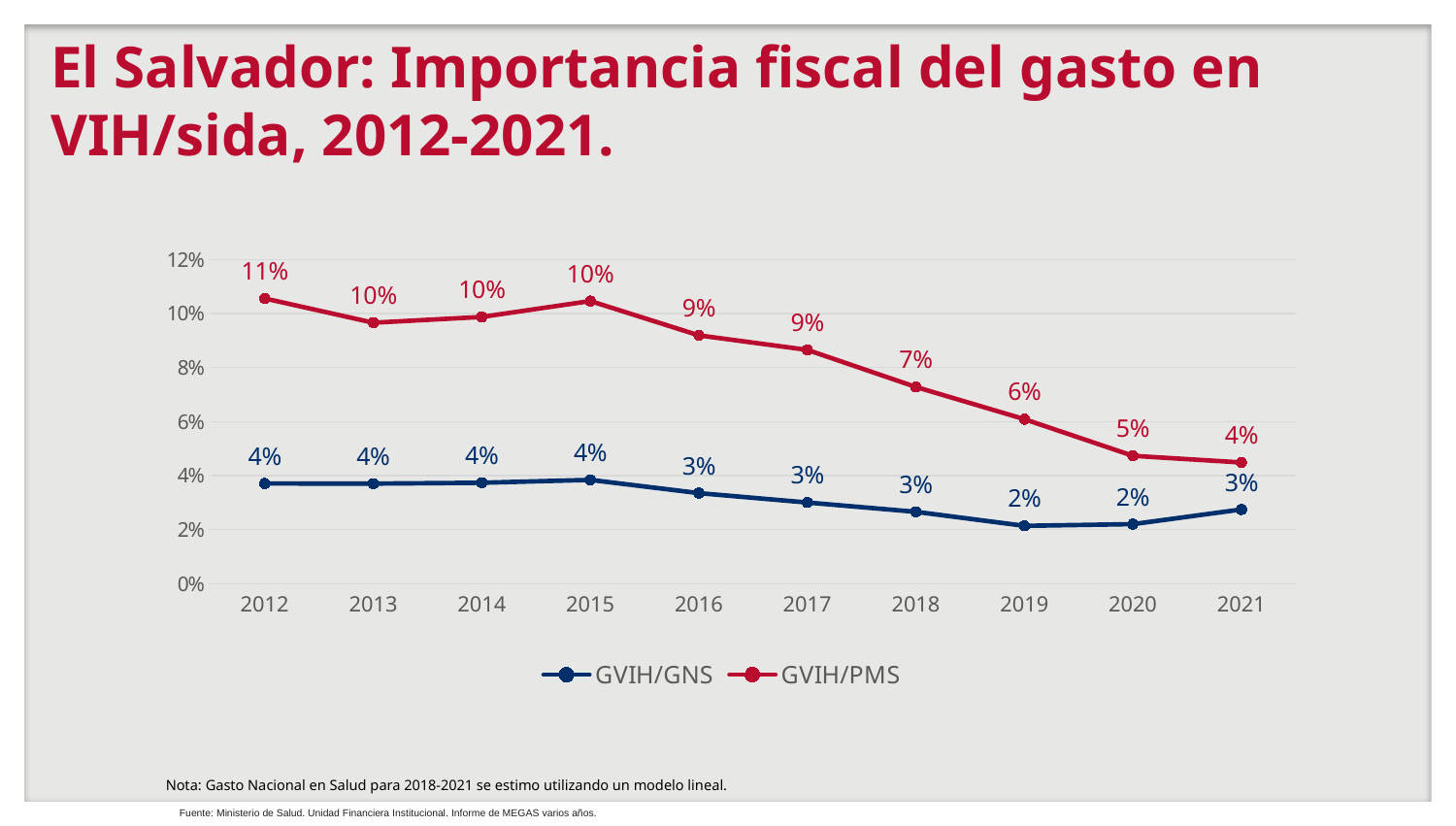
What is the value of GVIH/PMS in 2012? 11% Which series has the larger value in 2015, GVIH/GNS or GVIH/PMS? GVIH/PMS What kind of chart is shown on the slide? line chart In which year is GVIH/PMS at its highest? 2012 What is the value of GVIH/GNS in 2019? 2% Is the value for GVIH/PMS in 2017 greater or less than 8%? greater Does GVIH/PMS generally rise or fall from 2012 to 2021? fall How many years are shown on the x axis? 10 What is the lowest labelled value of GVIH/GNS? 2% How many series does the legend list? 2 What is the value of GVIH/PMS in 2021? 4% What is the difference between GVIH/PMS and GVIH/GNS in 2018? 4%